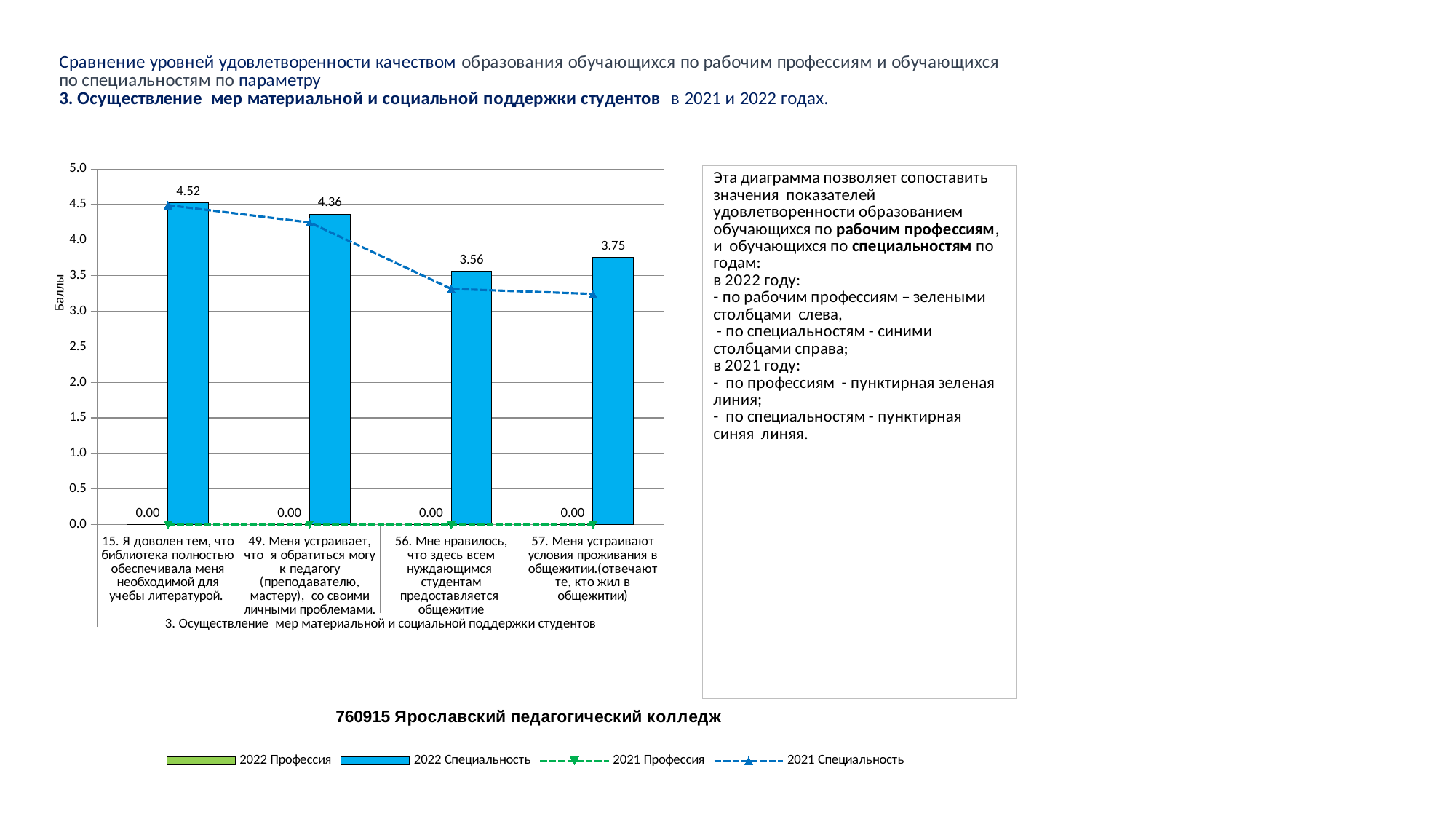
What is the difference between the 2022 Специальность values for category 15 and category 56? 0.96 Which is larger for 2022 Специальность: category 56 or category 57? 57. Меня устраивают условия проживания в общежитии Is the 2021 Специальность value for category 57 greater or less than 3.5? less What is the value of the 2022 Специальность bar for category 57 (Меня устраивают условия проживания в общежитии)? 3.75 What is the value of the 2022 Специальность bar for category 56 (Мне нравилось, что здесь всем нуждающимся студентам предоставляется общежитие)? 3.56 Which category has the highest 2022 Специальность value? 15. Я доволен тем, что библиотека полностью обеспечивала меня необходимой для учебы литературой. Which category has the lowest 2022 Специальность value? 56. Мне нравилось, что здесь всем нуждающимся студентам предоставляется общежитие How many series does the legend list? 4 What value is shown for the 2022 Профессия series in every category? 0.00 What is the value of the 2022 Специальность bar for category 15 (Я доволен тем, что библиотека полностью обеспечивала меня необходимой для учебы литературой)? 4.52 How many categories are shown on the x axis? 4 What is the value of the 2022 Специальность bar for category 49 (Меня устраивает, что я обратиться могу к педагогу)? 4.36